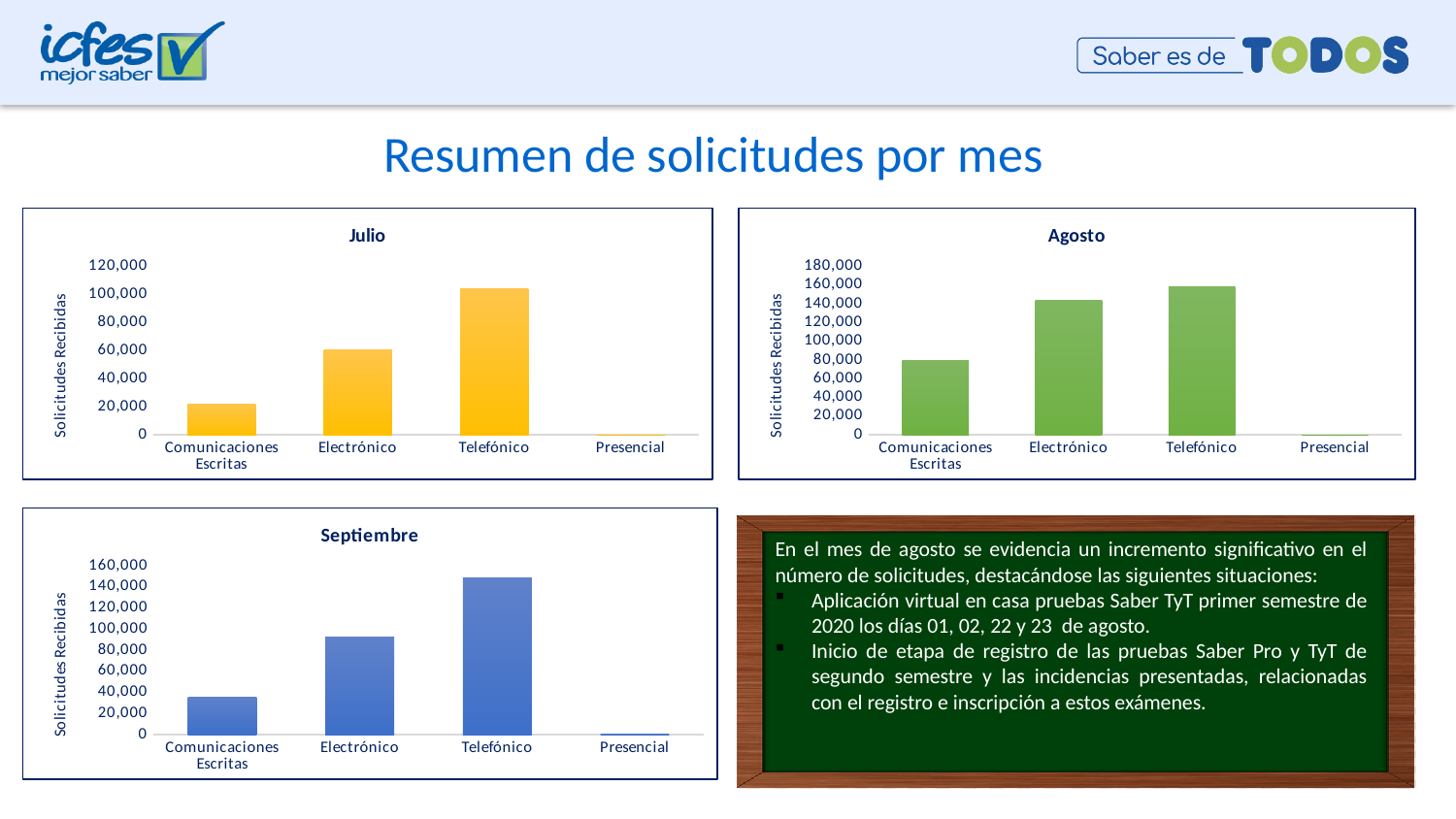
In the Septiembre chart, is the value for Telefónico greater or less than 120,000? greater In the Agosto chart, is the value for Electrónico greater or less than 160,000? less What kind of chart is the Septiembre chart? Bar chart In the Julio chart, which category has the lowest number of solicitudes recibidas? Presencial In the Julio chart, is the value for Telefónico greater or less than 100,000? greater In the Septiembre chart, which is larger, Electrónico or Comunicaciones Escritas? Electrónico In the Septiembre chart, which category has the lowest number of solicitudes recibidas? Presencial How many categories are shown on the x axis of the Agosto chart? 4 In the Agosto chart, which category has the highest number of solicitudes recibidas? Telefónico In the Julio chart, which category has the highest number of solicitudes recibidas? Telefónico